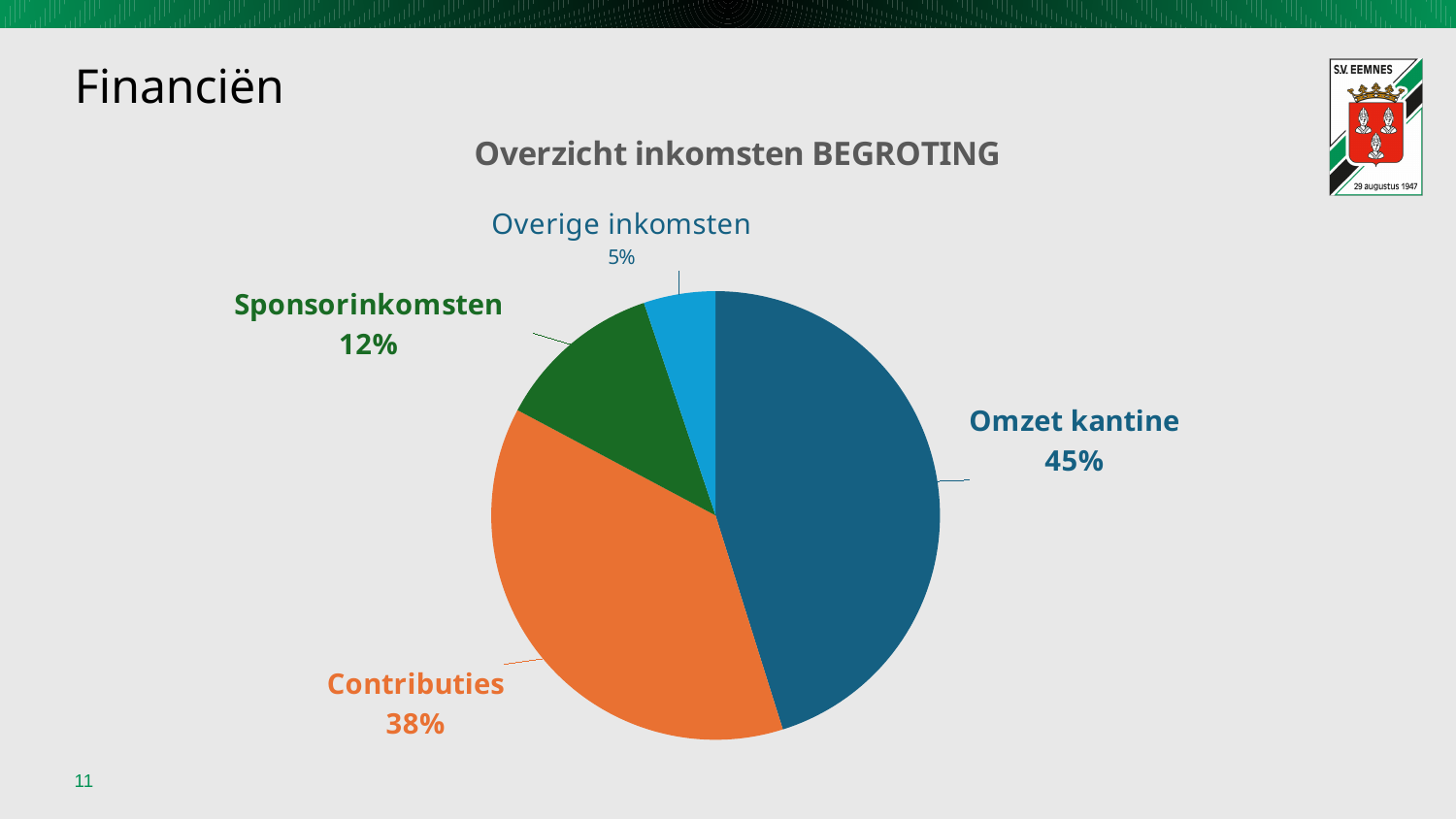
Which category has the smallest slice of the pie? Overige inkomsten What share of the pie does Omzet kantine represent? 45% What is the value shown for Sponsorinkomsten? 12% What is the title of the chart? Overzicht inkomsten BEGROTING Which is larger, Sponsorinkomsten or Overige inkomsten? Sponsorinkomsten How many categories are shown in the pie chart? 4 Which category has the largest slice of the pie? Omzet kantine What is the difference between the shares of Omzet kantine and Contributies? 7% What colour is the Contributies slice? orange What type of chart is shown on the slide? pie chart What share of the pie does Contributies represent? 38% What is the value shown for Overige inkomsten? 5%